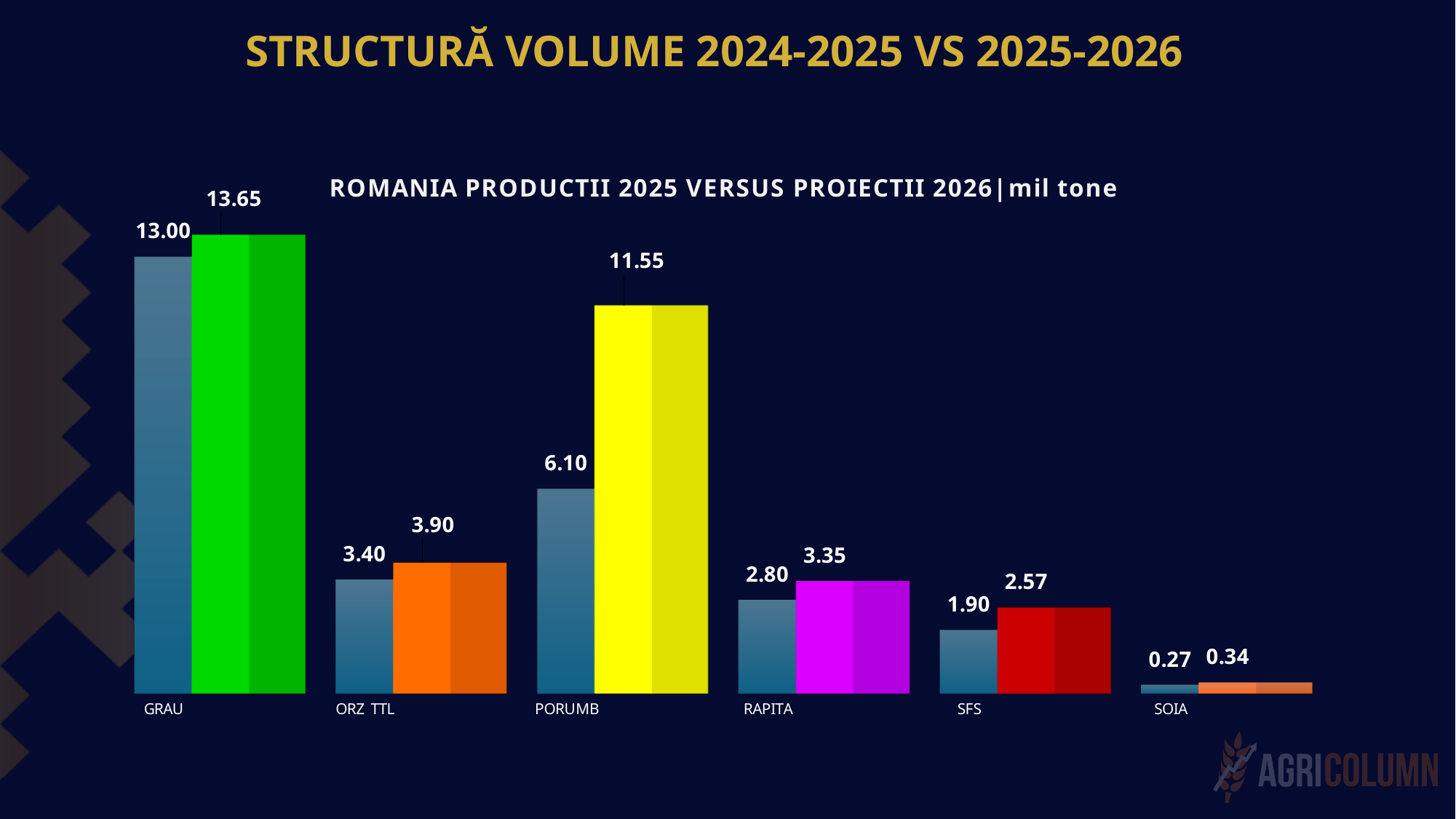
Which category has the lowest 2025 production value? SOIA What is the difference between the 2026 projection and the 2025 production for GRAU? 0.65 What is the 2025 production value (left bar) for GRAU? 13.00 What kind of chart is shown on the slide? Bar chart Which category has the highest 2026 projection value? GRAU What is the 2026 projection value (right bar) for PORUMB? 11.55 What is the 2025 production value (left bar) for SOIA? 0.27 How many crop categories are shown on the x axis? 6 Which is larger: the 2026 projection for ORZ TTL or the 2026 projection for RAPITA? ORZ TTL What is the 2026 projection value (right bar) for SFS? 2.57 What is the title of the chart? ROMANIA PRODUCTII 2025 VERSUS PROIECTII 2026|mil tone What is the difference between the 2026 projection and the 2025 production for PORUMB? 5.45